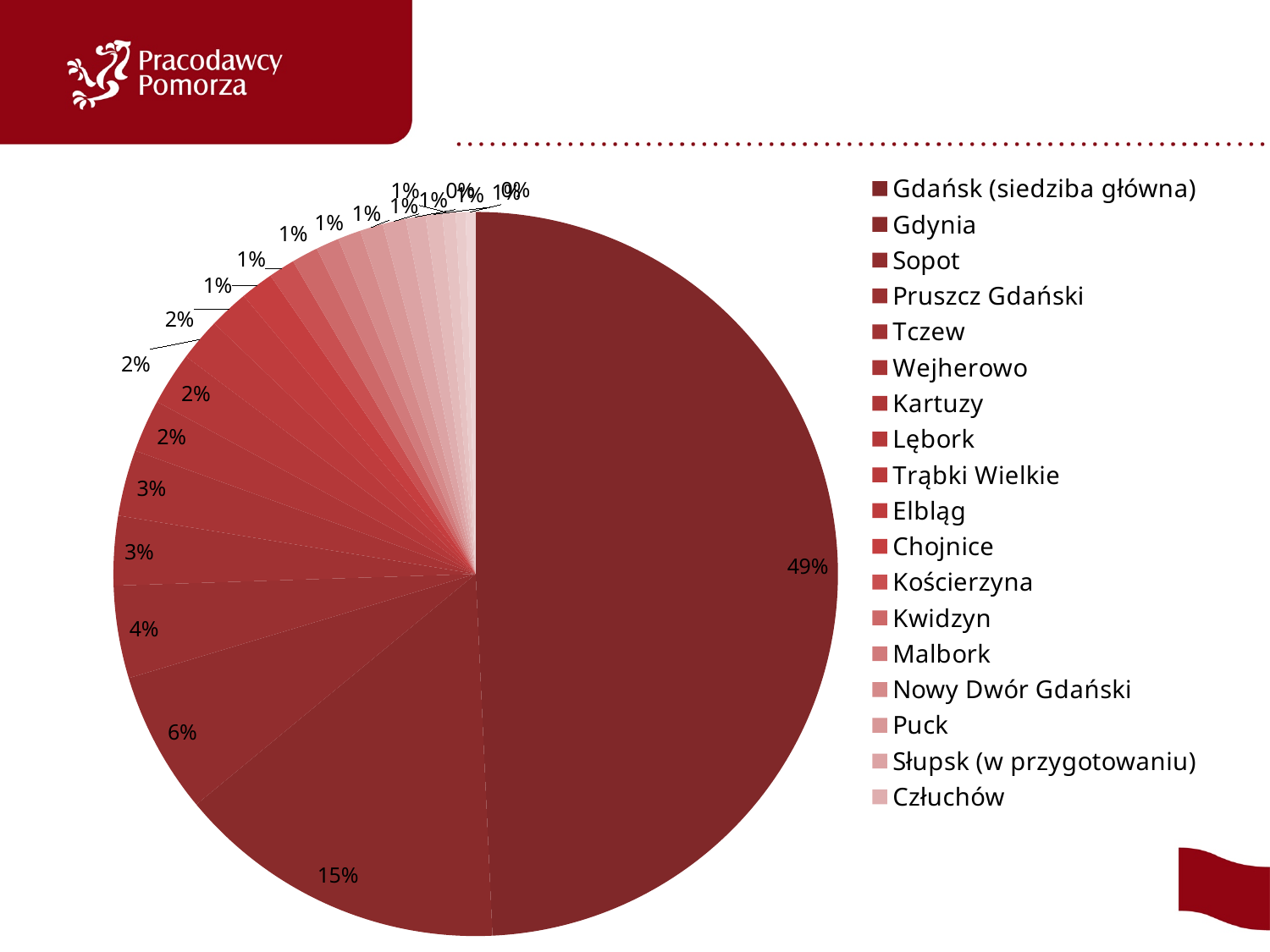
What is the value shown for Sopot? 6% What is the value shown for Pruszcz Gdański? 4% Which is larger, the slice for Gdynia or the slice for Sopot? Gdynia How many categories does the legend of the pie chart list? 18 What is the value shown for Tczew? 3% Which category has the largest slice of the pie chart? Gdańsk (siedziba główna) What share of the pie does Gdańsk (siedziba główna) have? 49% What is the difference in percentage points between Gdańsk (siedziba główna) and Gdynia? 34 percentage points What kind of chart is shown on the slide? pie chart Which is larger, the slice for Sopot or the slice for Pruszcz Gdański? Sopot What is the value shown for Gdynia? 15% Which legend entry is marked as the main office (siedziba główna)? Gdańsk